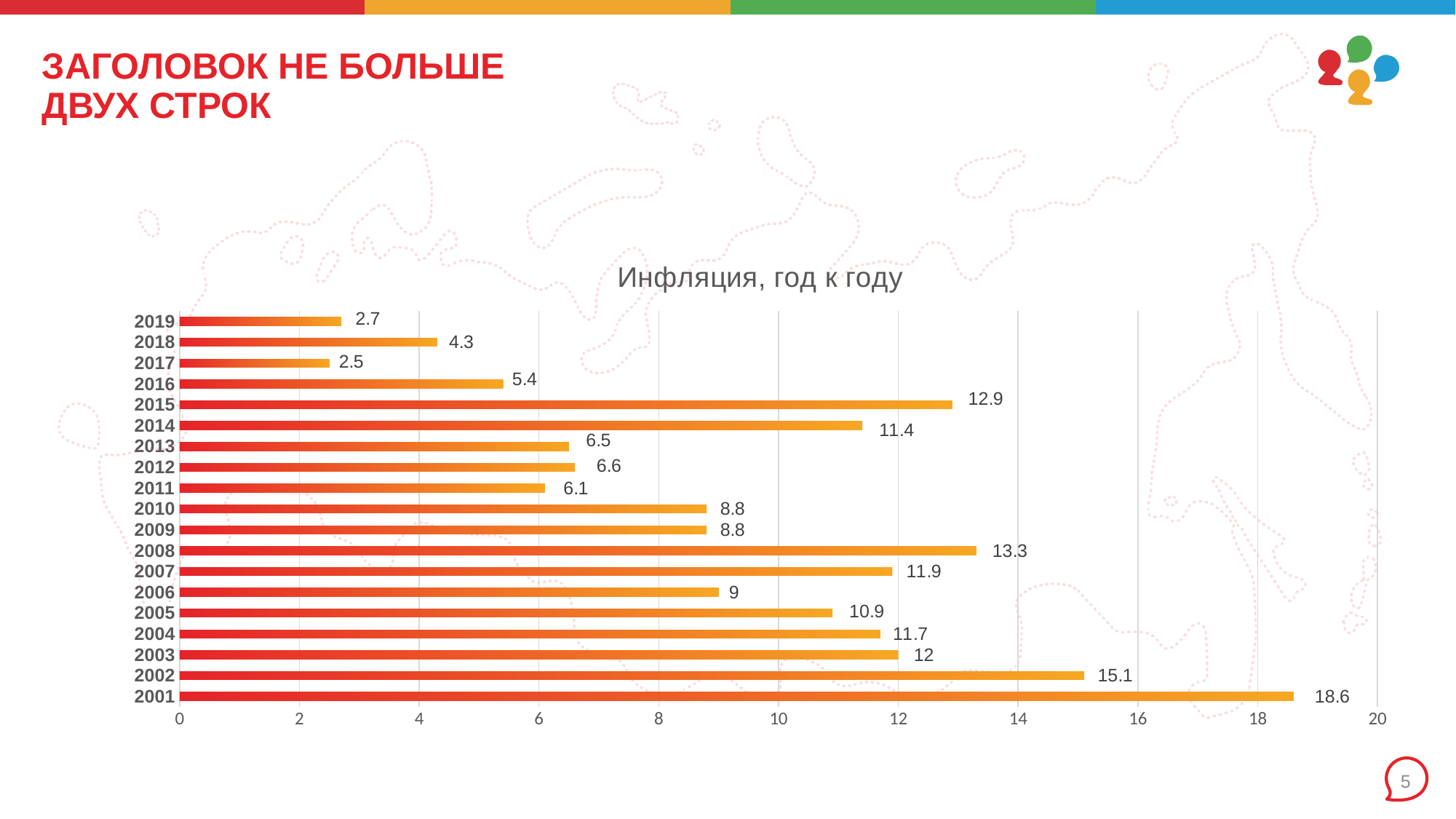
What is the difference between the inflation values for 2018 and 2019? 1.6 How many years are shown in the chart? 19 What is the difference between the inflation values for 2001 and 2002? 3.5 Which year has a larger inflation value, 2008 or 2015? 2008 What is the inflation value for 2015? 12.9 What kind of chart is shown on the slide? bar chart Which year has the highest inflation value? 2001 What is the title of the chart? Инфляция, год к году What is the maximum value shown on the horizontal axis? 20 What is the inflation value for 2006? 9 Which year has the lowest inflation value? 2017 Is the value for 2014 greater or less than 10? greater